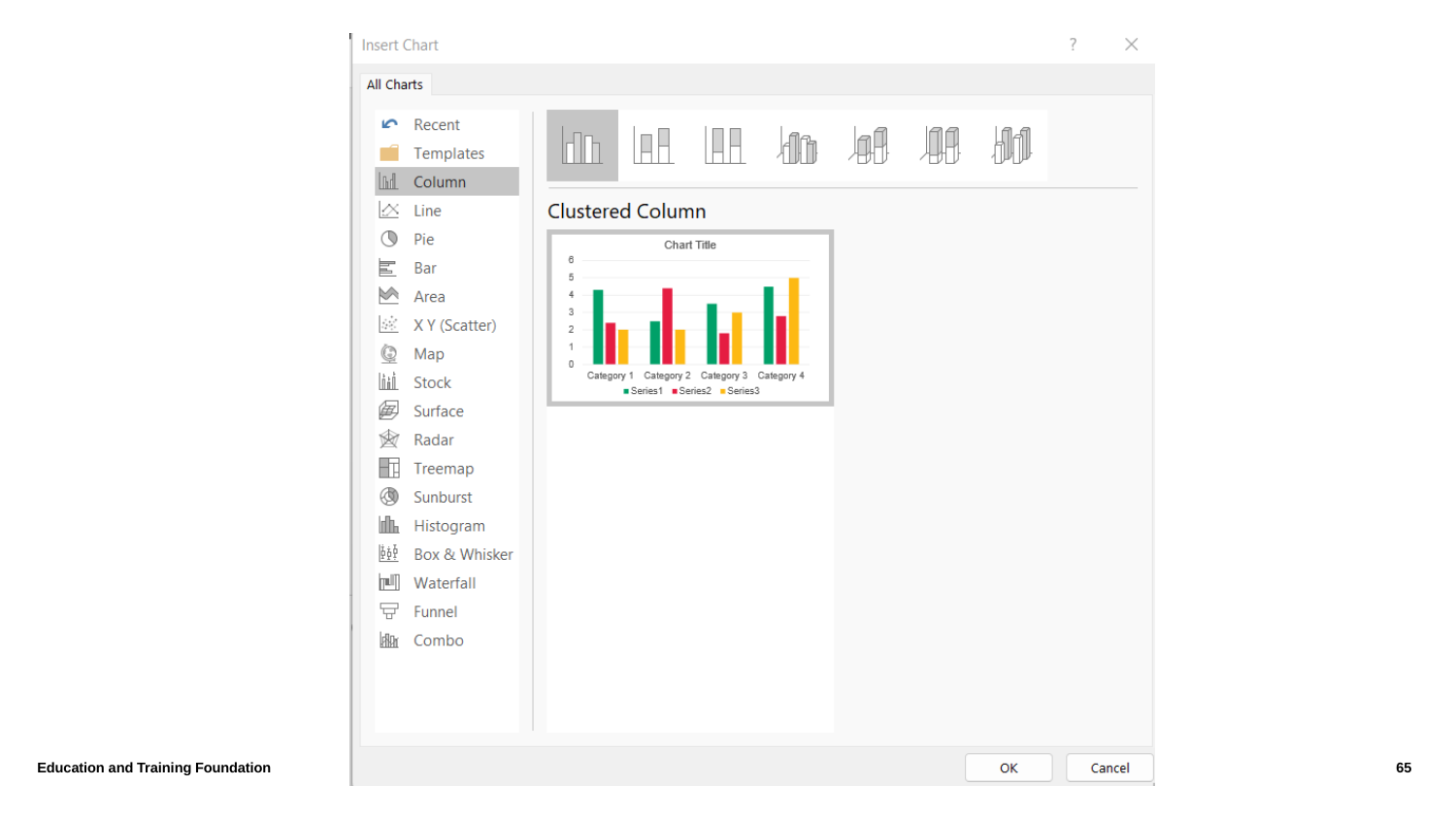
In the preview chart, is the Series2 value for Category 3 greater or less than 3? less What is the title of the preview chart? Chart Title How many categories are shown on the x axis of the preview chart? 4 What are the legend entries of the preview chart? Series1, Series2, Series3 In the preview chart, for Category 2, which is larger: Series1 or Series2? Series2 In the preview chart, is the Series1 value for Category 1 greater or less than 3? greater In the preview chart, which category has the lowest Series2 bar? Category 3 In the preview chart, which category has the highest Series3 bar? Category 4 How many series does the legend of the preview chart list? 3 What kind of chart is shown in the preview of the Insert Chart dialog? bar chart In the preview chart, is the Series3 value for Category 4 greater or less than 4? greater In the preview chart, for Category 3, which is larger: Series1 or Series2? Series1